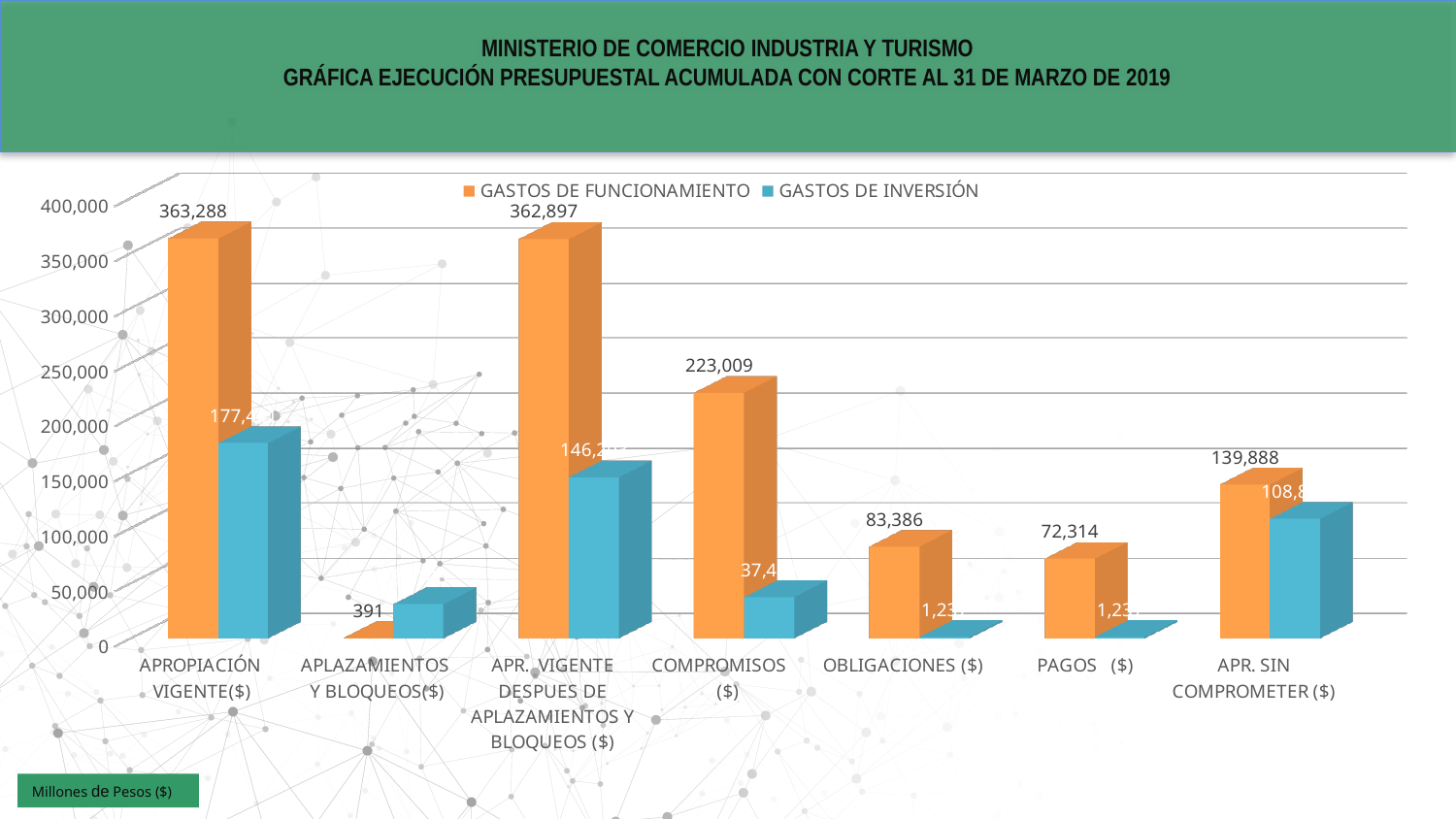
Which is larger for GASTOS DE FUNCIONAMIENTO: COMPROMISOS ($) or APR. SIN COMPROMETER ($)? COMPROMISOS ($) What is the difference between the GASTOS DE FUNCIONAMIENTO values for OBLIGACIONES ($) and PAGOS ($)? 11,072 Which category has the highest GASTOS DE FUNCIONAMIENTO value? APROPIACIÓN VIGENTE($) How many categories are shown on the x axis? 7 Which category has the lowest GASTOS DE FUNCIONAMIENTO value? APLAZAMIENTOS Y BLOQUEOS($) What is the value of GASTOS DE FUNCIONAMIENTO for PAGOS ($)? 72,314 How many series does the legend list? 2 What is the value of GASTOS DE FUNCIONAMIENTO for APR. SIN COMPROMETER ($)? 139,888 What is the value of GASTOS DE FUNCIONAMIENTO for COMPROMISOS ($)? 223,009 What is the value of GASTOS DE FUNCIONAMIENTO for APROPIACIÓN VIGENTE($)? 363,288 What kind of chart is shown on the slide? bar chart Is the GASTOS DE INVERSIÓN value for APROPIACIÓN VIGENTE($) greater or less than 150,000? greater